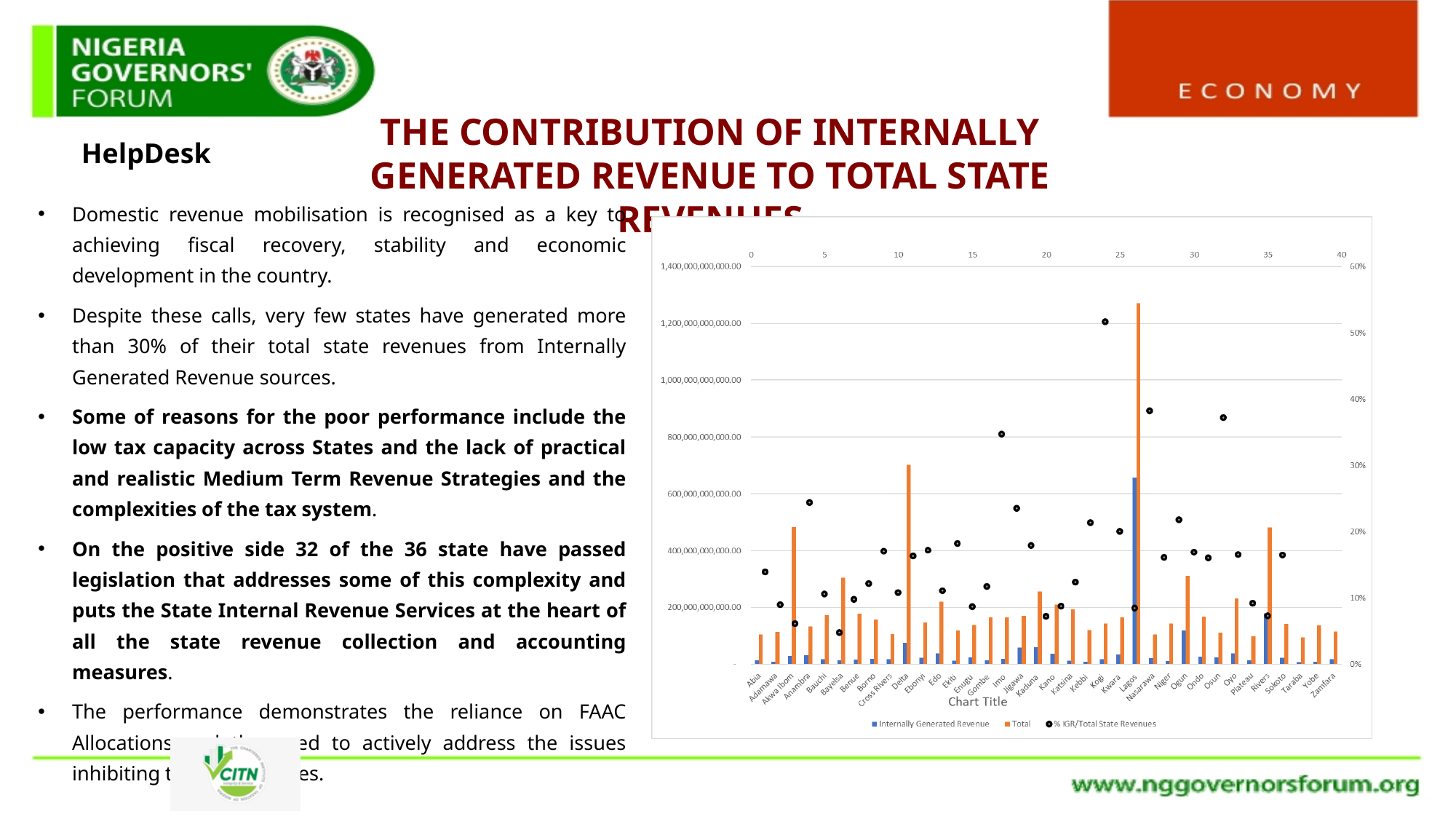
What colour are the Total bars in the chart? orange How many states are shown along the x axis of the chart? 36 Is the Total value for Lagos greater or less than 1,200,000,000,000.00? greater Which state has the highest Internally Generated Revenue bar? Lagos Is the Total value for Abia greater or less than 200,000,000,000.00? less Is the Internally Generated Revenue value for Lagos greater or less than 400,000,000,000.00? greater Which has the larger Total bar, Delta or Akwa Ibom? Delta What are the three series named in the chart legend? Internally Generated Revenue, Total, % IGR/Total State Revenues Which state has the highest Total bar in the chart? Lagos How many series does the chart legend list? 3 What kind of chart is used to show Internally Generated Revenue and Total? bar chart